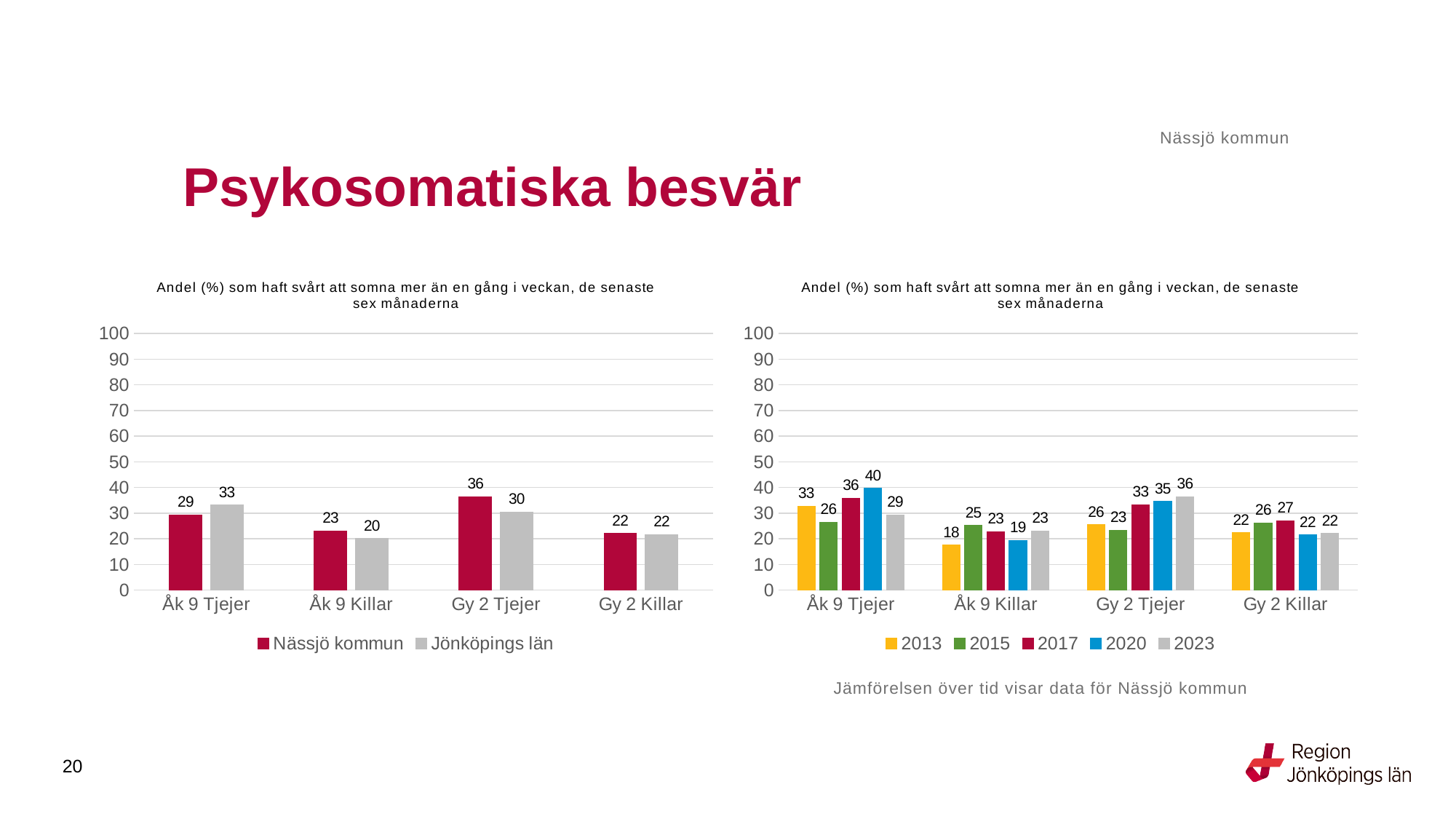
What kind of chart is the left chart? Bar chart In the right chart, which is larger for Åk 9 Killar: the value for 2015 or the value for 2020? 2015 In the right chart, how many categories are shown on the x axis? 4 In the left chart, how many series does the legend list? 2 In the right chart, what is the value for 2020 for Åk 9 Tjejer? 40 In the left chart, which category has the highest value for Nässjö kommun? Gy 2 Tjejer In the right chart, what is the value for 2013 for Åk 9 Killar? 18 In the right chart, how many series does the legend list? 5 In the left chart, what is the difference between Nässjö kommun and Jönköpings län for Åk 9 Tjejer? 4 In the left chart, what is the value for Nässjö kommun for Gy 2 Tjejer? 36 In the left chart, what is the value for Jönköpings län for Åk 9 Killar? 20 In the right chart, which year has the lowest value for Gy 2 Tjejer? 2015